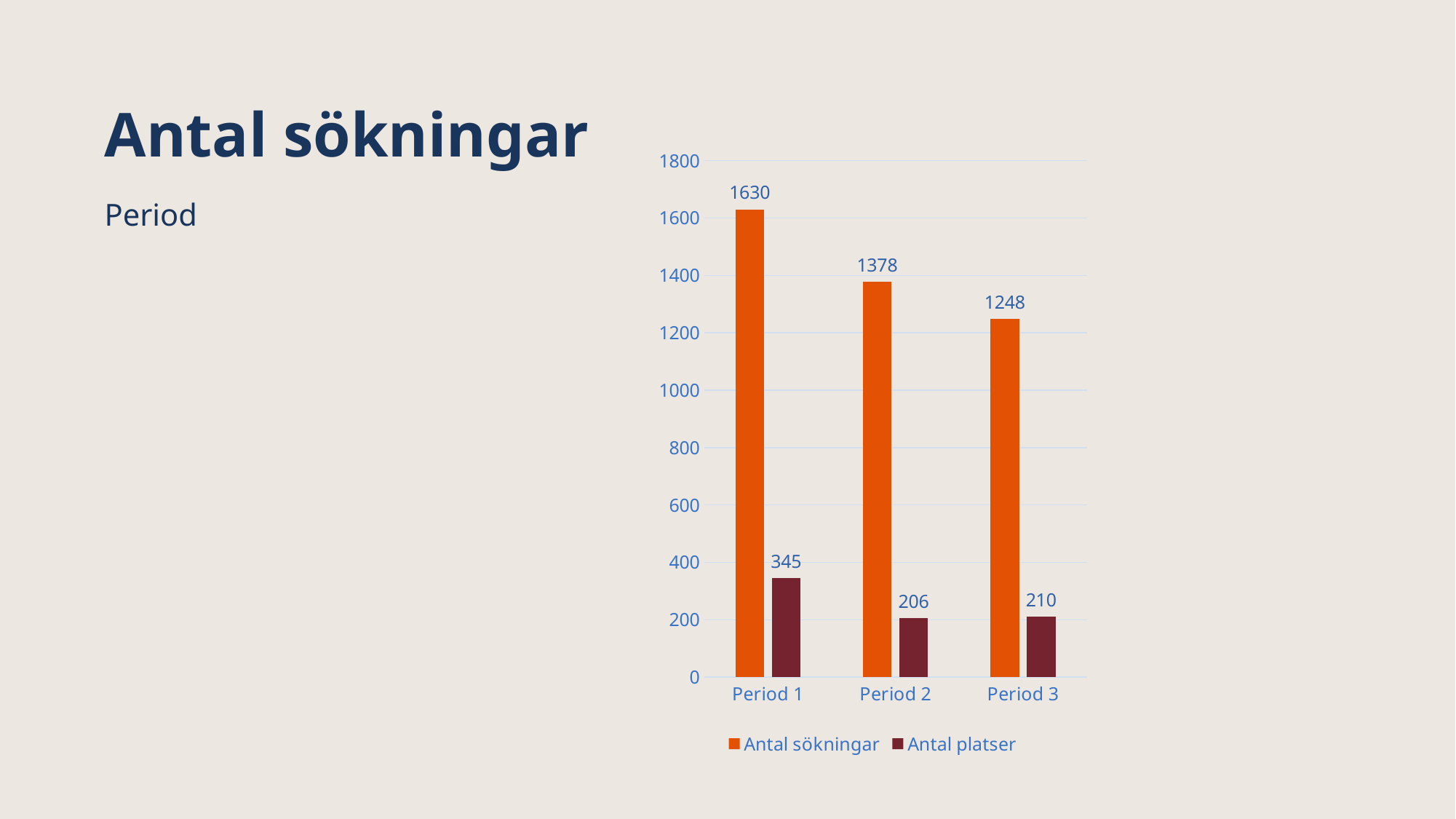
What is the value of Antal platser for Period 2? 206 Is the value of Antal sökningar for Period 2 greater or less than 1400? less What is the value of Antal platser for Period 3? 210 Which is larger, Antal platser for Period 1 or Antal platser for Period 3? Period 1 What is the value of Antal sökningar for Period 1? 1630 Which period has the highest value for Antal sökningar? Period 1 How many periods are shown on the x axis? 3 What is the difference between Antal sökningar and Antal platser for Period 3? 1038 How many series does the legend list? 2 Does Antal sökningar rise or fall from Period 1 to Period 3? fall What is the difference between Antal sökningar for Period 1 and Period 2? 252 Which period has the lowest value for Antal platser? Period 2